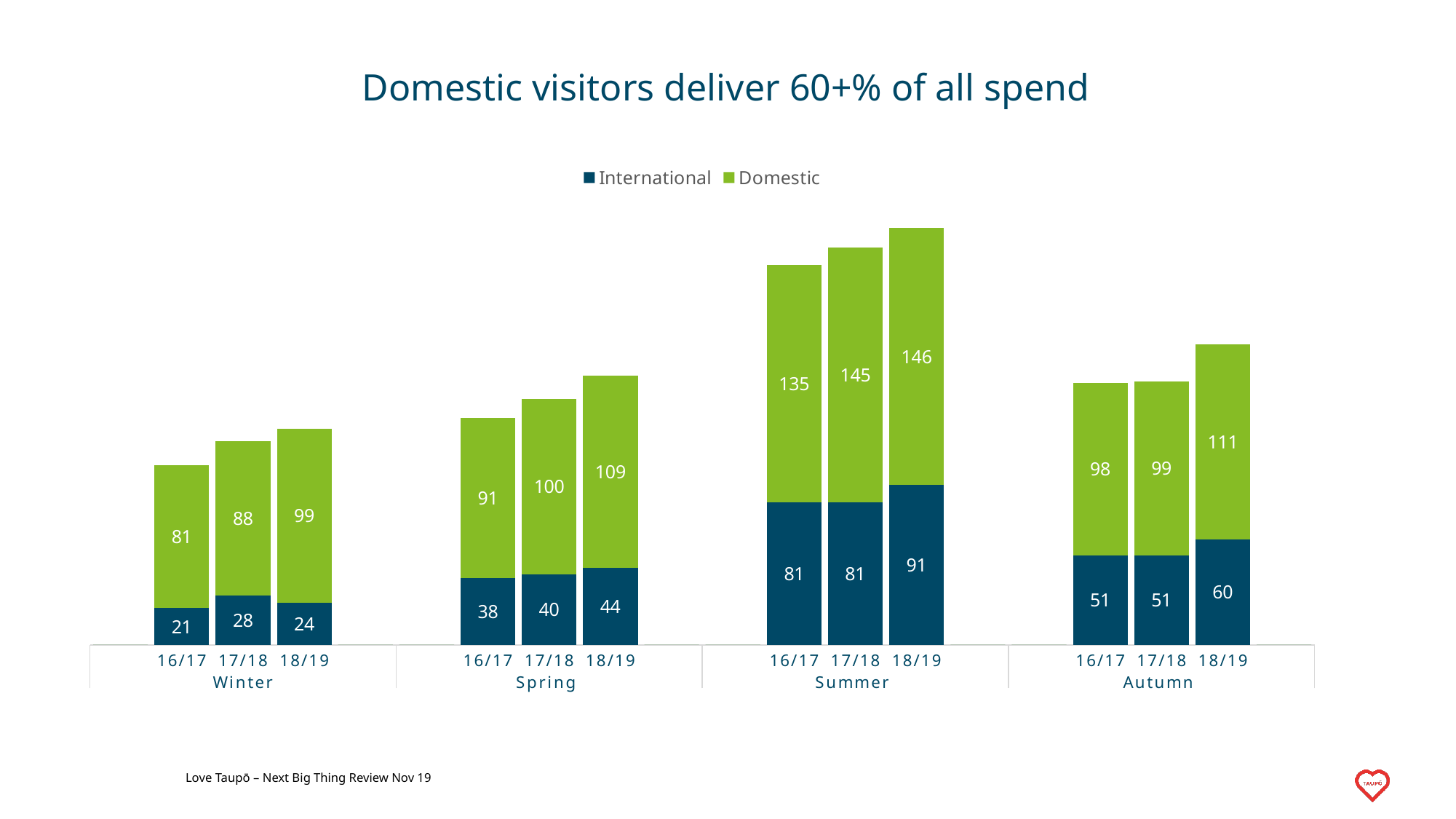
Which season and year has the lowest International value? Winter 16/17 What is the difference between the Domestic values for Spring 18/19 and Spring 16/17? 18 Which is larger, the International value for Autumn 18/19 or for Spring 18/19? Autumn 18/19 Do the Domestic values for Spring rise or fall from 16/17 to 18/19? Rise What is the International value for Winter 16/17? 21 Which season and year has the highest Domestic value? Summer 18/19 What is the total of the stacked bar for Winter 16/17? 102 What type of chart is shown on the slide? Stacked bar chart What is the Domestic value for Summer 18/19? 146 How many series does the legend list? 2 What is the total of the stacked bar for Summer 18/19? 237 What is the Domestic value for Autumn 18/19? 111